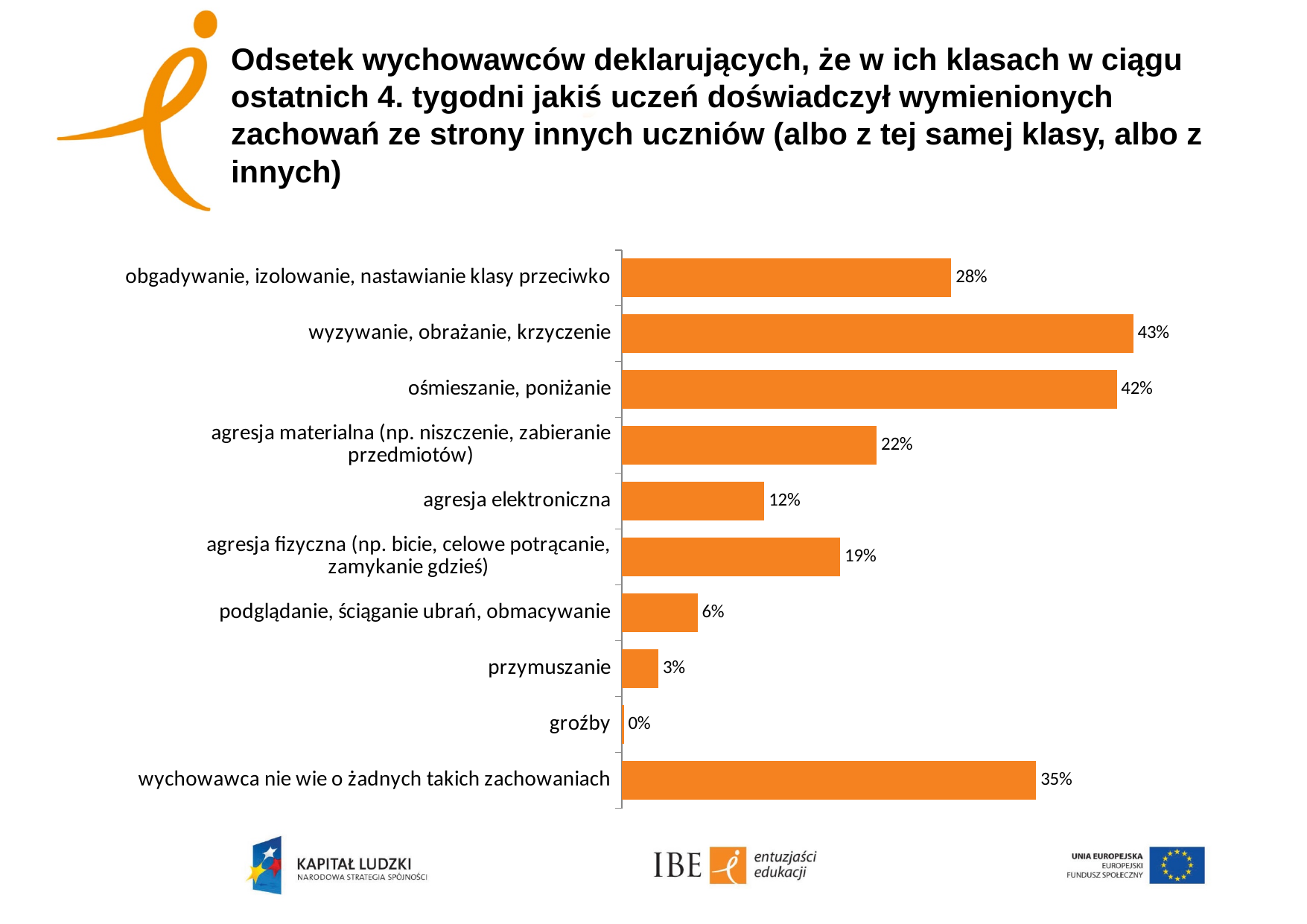
Which category has the highest value? wyzywanie, obrażanie, krzyczenie Which is larger: the value for "agresja fizyczna (np. bicie, celowe potrącanie, zamykanie gdzieś)" or for "agresja elektroniczna"? agresja fizyczna (np. bicie, celowe potrącanie, zamykanie gdzieś) What is the difference between the values for "obgadywanie, izolowanie, nastawianie klasy przeciwko" and "agresja materialna (np. niszczenie, zabieranie przedmiotów)"? 6 percentage points What is the difference between the values for "podglądanie, ściąganie ubrań, obmacywanie" and "przymuszanie"? 3 percentage points How many categories are shown in the chart? 10 What kind of chart is shown on the slide? bar chart Which category has the lowest value? groźby What value is shown for "agresja elektroniczna"? 12% What colour are the bars in the chart? orange What percentage is shown for "wychowawca nie wie o żadnych takich zachowaniach"? 35% What value is shown for "groźby"? 0% What percentage is shown for "wyzywanie, obrażanie, krzyczenie"? 43%